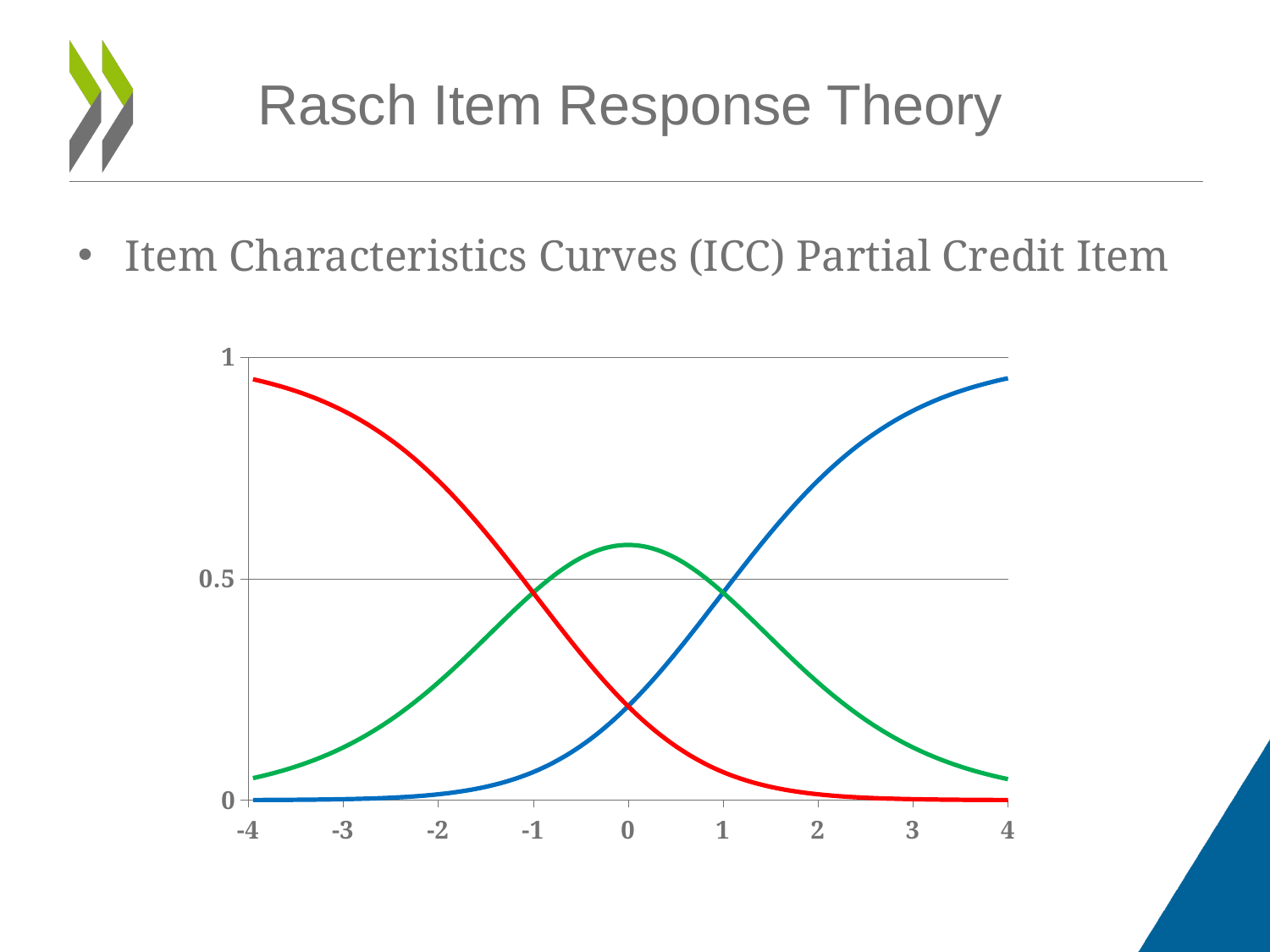
Is the value of the red curve at x = -4 greater or less than 0.5? greater What are the lowest and highest values labelled on the x axis? -4 and 4 Is the value of the green curve at x = -4 greater or less than 0.5? less Does the blue curve rise or fall as the x axis goes from -4 to 4? rise Does the red curve rise or fall as the x axis goes from -4 to 4? fall At x = -4, which curve has the higher value, the red curve or the green curve? red curve What kind of chart is shown on the slide? line chart Is the value of the red curve at x = 4 greater or less than 0.5? less Which curve reaches its peak at x = 0? green curve At x = 4, which curve has the higher value, the blue curve or the green curve? blue curve How many curves are plotted on the chart? 3